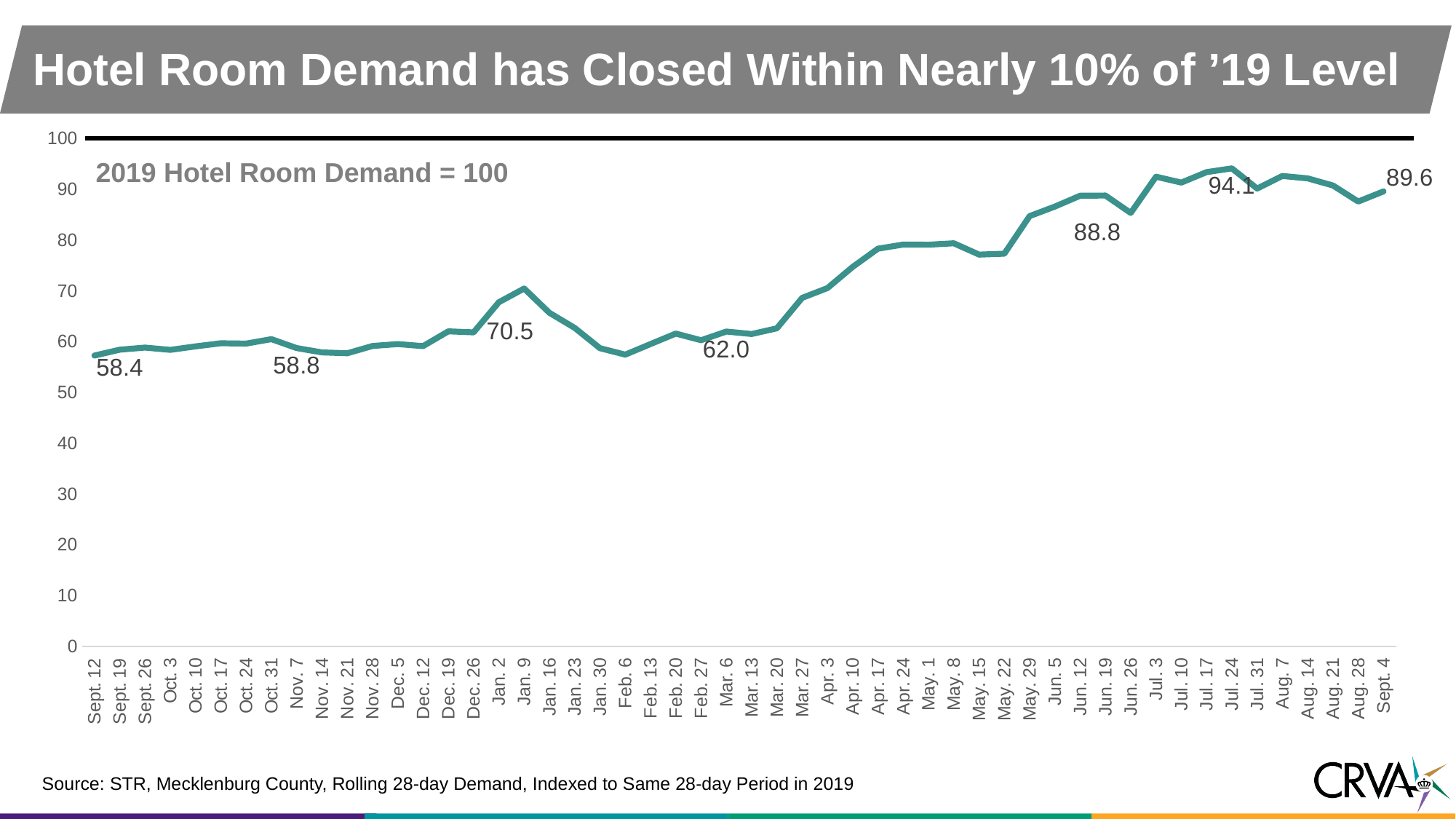
Is the value for Apr. 17 greater or less than 70? greater What baseline does the chart's note say 2019 hotel room demand is set equal to? 100 What is the indexed hotel room demand value for Jul. 24? 94.1 What type of chart is shown on the slide? line chart Which is larger, the value for Jun. 12 or the value for Oct. 31? Jun. 12 What is the indexed hotel room demand value for Jan. 9? 70.5 What is the difference between the values for Jan. 9 and Mar. 6? 8.5 Which date has the highest indexed hotel room demand? Jul. 24 What is the indexed hotel room demand value for Sept. 4? 89.6 Does the indexed hotel room demand generally rise or fall from Sept. 12 to Sept. 4? rise